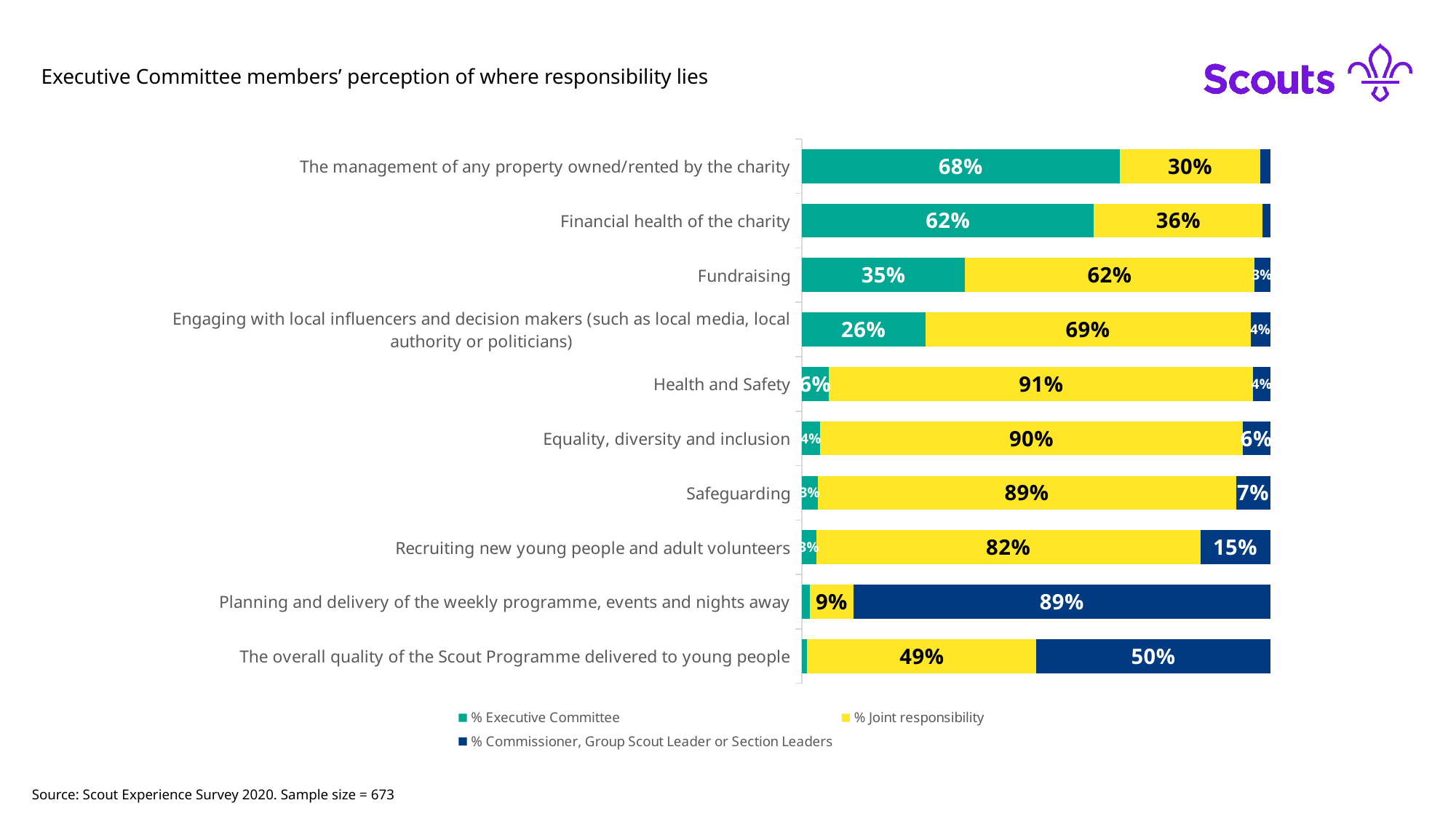
What is the title of the chart on the slide? Executive Committee members' perception of where responsibility lies Which has the larger % Joint responsibility value: Safeguarding or Recruiting new young people and adult volunteers? Safeguarding What is the % Joint responsibility value for Fundraising? 62% What kind of chart is shown on the slide? Stacked bar chart For Financial health of the charity, how many percentage points higher is the % Executive Committee value than the % Joint responsibility value? 26 percentage points What is the % Commissioner, Group Scout Leader or Section Leaders value for planning and delivery of the weekly programme, events and nights away? 89% What percentage of Executive Committee members see the Executive Committee as responsible for the management of any property owned/rented by the charity? 68% What is the % Joint responsibility value for Health and Safety? 91% How many categories are shown on the chart? 10 Which category has the highest % Commissioner, Group Scout Leader or Section Leaders value? Planning and delivery of the weekly programme, events and nights away Which category has the highest % Executive Committee value? The management of any property owned/rented by the charity How many series does the legend list? 3